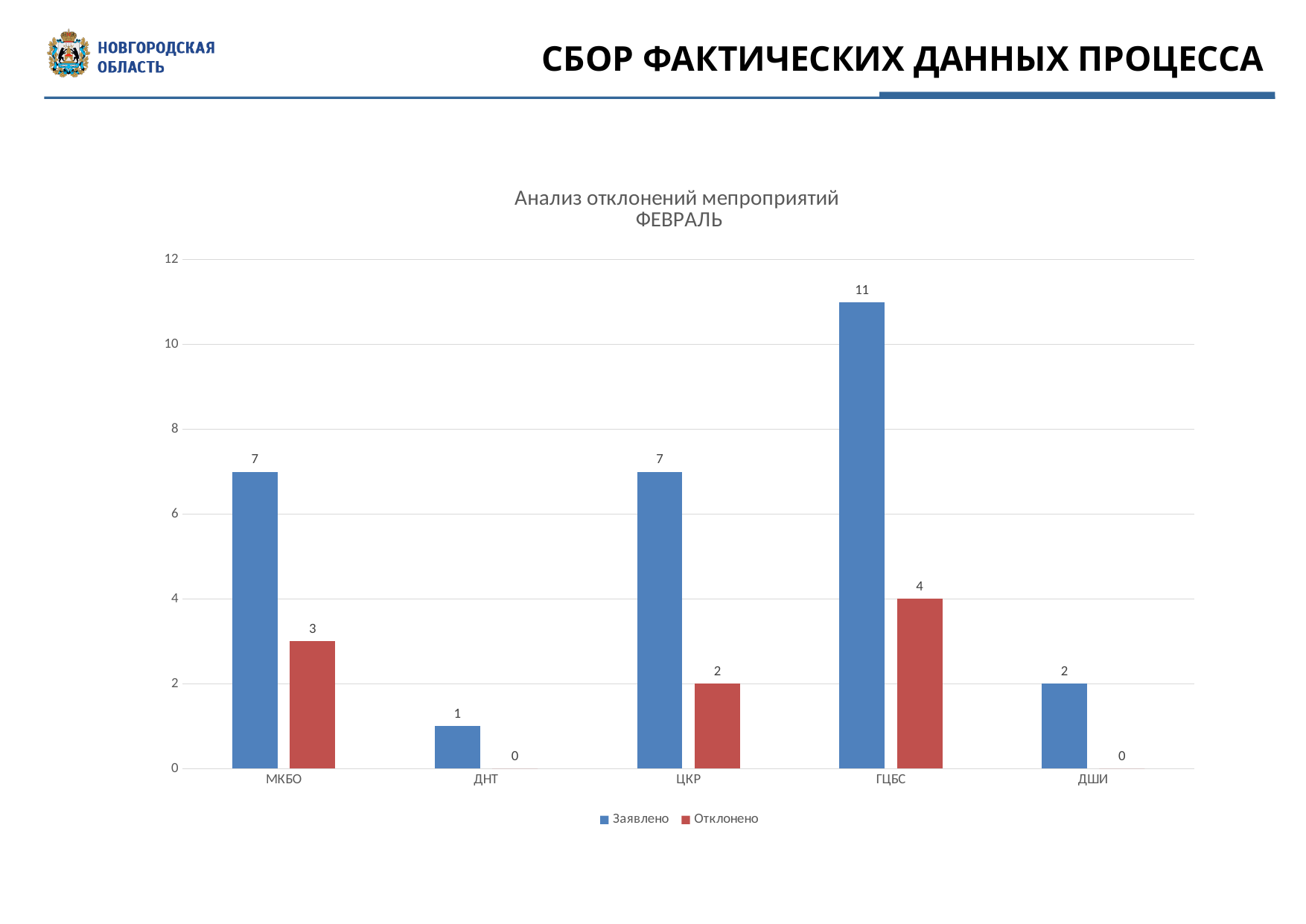
What is the value of Отклонено for ДШИ? 0 Which category has the lowest Заявлено value? ДНТ What kind of chart is shown on the slide? Bar chart Which is larger: Отклонено for ГЦБС or Отклонено for МКБО? Отклонено for ГЦБС What is the value of Заявлено for ДНТ? 1 What is the difference between Заявлено and Отклонено for ЦКР? 5 What is the value of Отклонено for МКБО? 3 How many series does the legend list? 2 Which category has the highest Заявлено value? ГЦБС How many categories are shown on the x axis? 5 What is the value of Заявлено for ГЦБС? 11 What is the title of the chart? Анализ отклонений мепроприятий ФЕВРАЛЬ